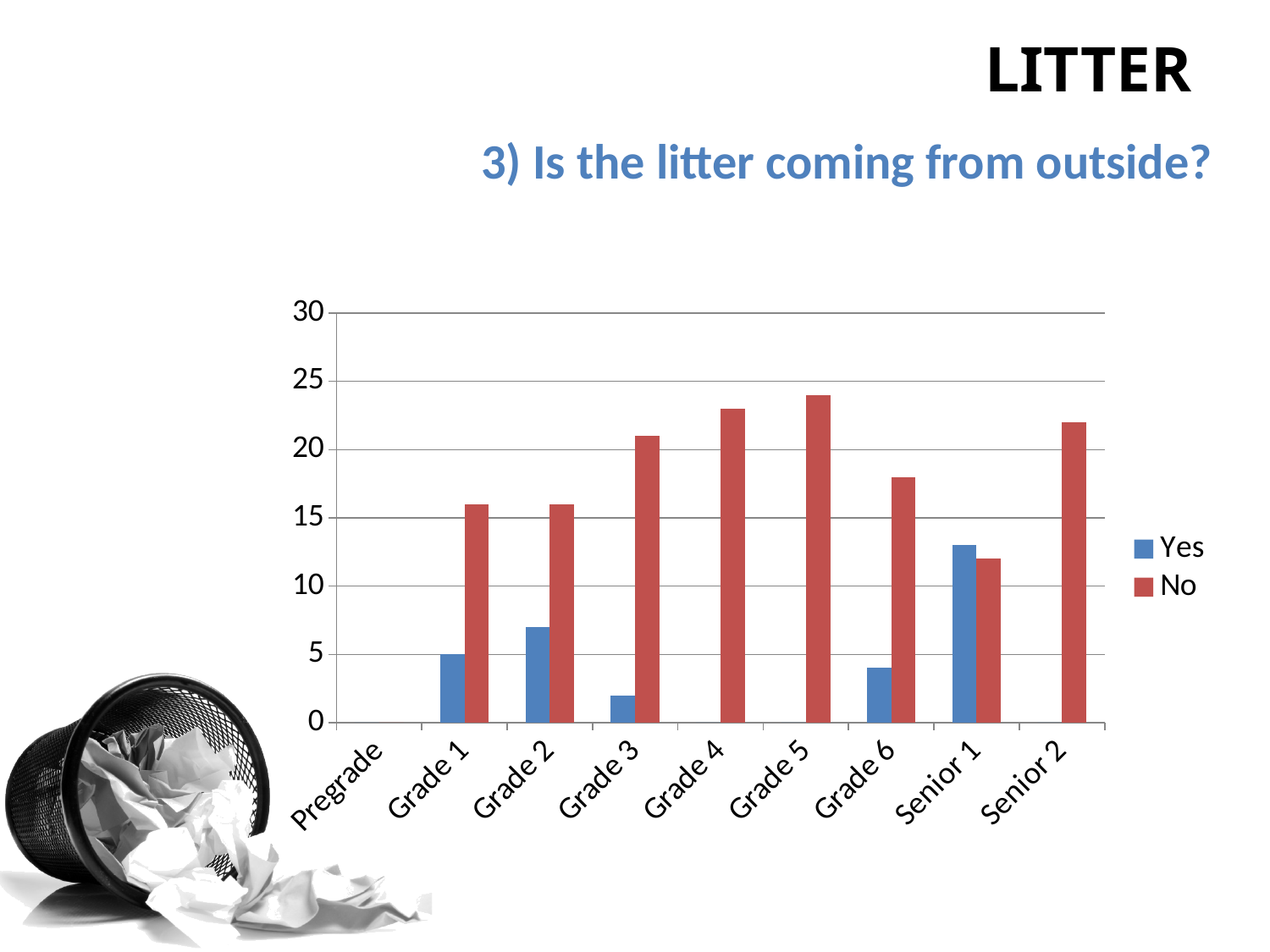
What is the value of the Yes bar for Grade 1? 5 How many series does the legend list? 2 Which category has the highest Yes value? Senior 1 What type of chart is shown on the slide? bar chart Is the No value for Grade 4 greater or less than 20? greater Is the Yes value for Grade 3 greater or less than 5? less Which series is shown in red? No What question does the chart's heading ask? 3) Is the litter coming from outside? Do the No values rise or fall from Grade 1 to Grade 5? rise Is the No value for Senior 1 greater or less than 15? less Which is larger, the No value for Grade 3 or the No value for Grade 6? Grade 3 How many categories are shown on the x axis? 9